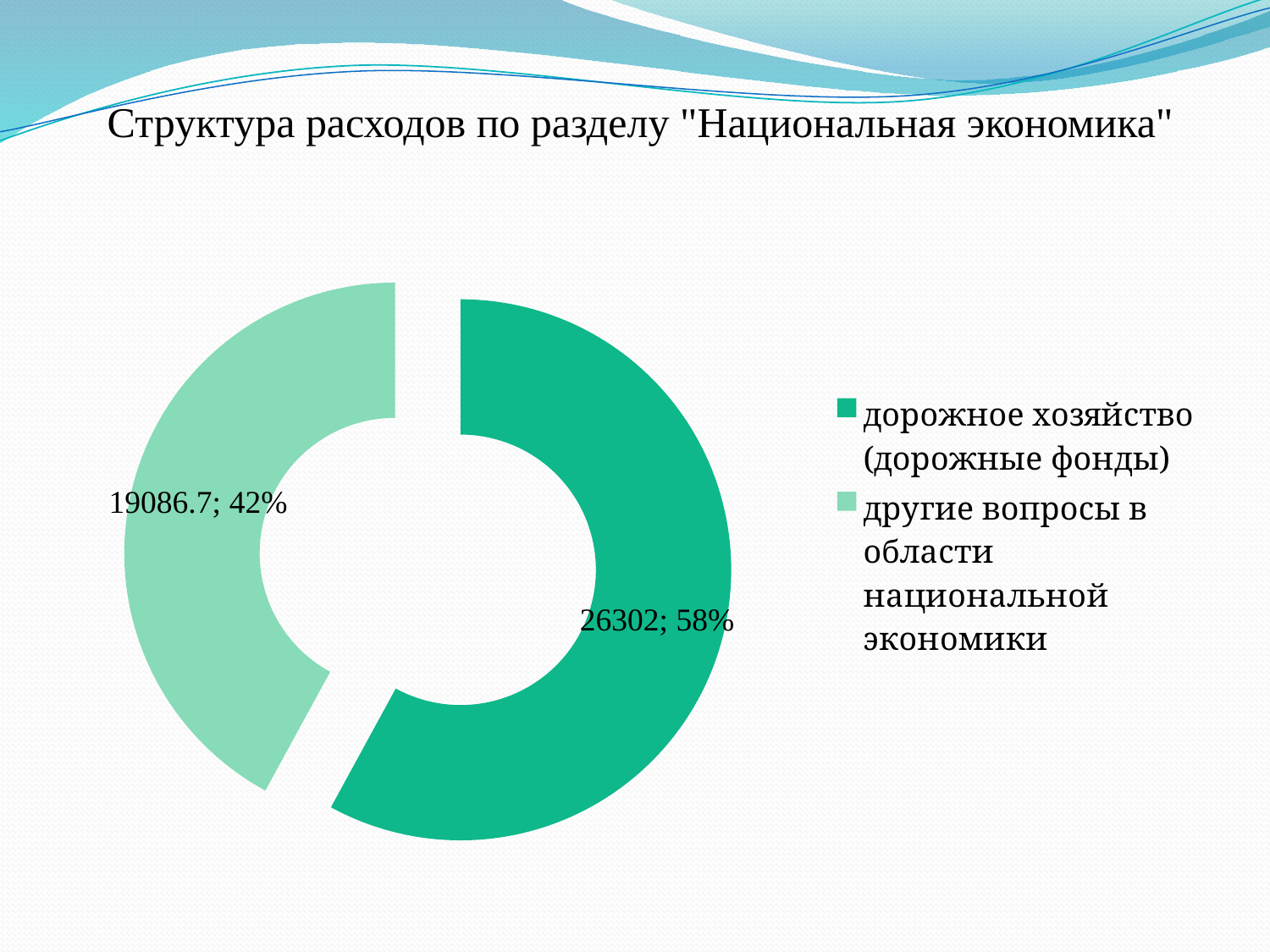
What kind of chart is shown on the slide? Doughnut (pie) chart Which category has the largest slice? дорожное хозяйство (дорожные фонды) What share of the chart does "дорожное хозяйство (дорожные фонды)" take? 58% Which category is shown in the lighter green colour? другие вопросы в области национальной экономики How many categories does the chart show? 2 Which category has the smallest slice? другие вопросы в области национальной экономики What is the value for "другие вопросы в области национальной экономики"? 19086.7 What share of the chart does "другие вопросы в области национальной экономики" take? 42% What is the difference between the values for "дорожное хозяйство (дорожные фонды)" and "другие вопросы в области национальной экономики"? 7215.3 What is the value for "дорожное хозяйство (дорожные фонды)"? 26302 What is the title of the slide? Структура расходов по разделу "Национальная экономика" Which is larger: the value for "дорожное хозяйство (дорожные фонды)" or for "другие вопросы в области национальной экономики"? дорожное хозяйство (дорожные фонды)